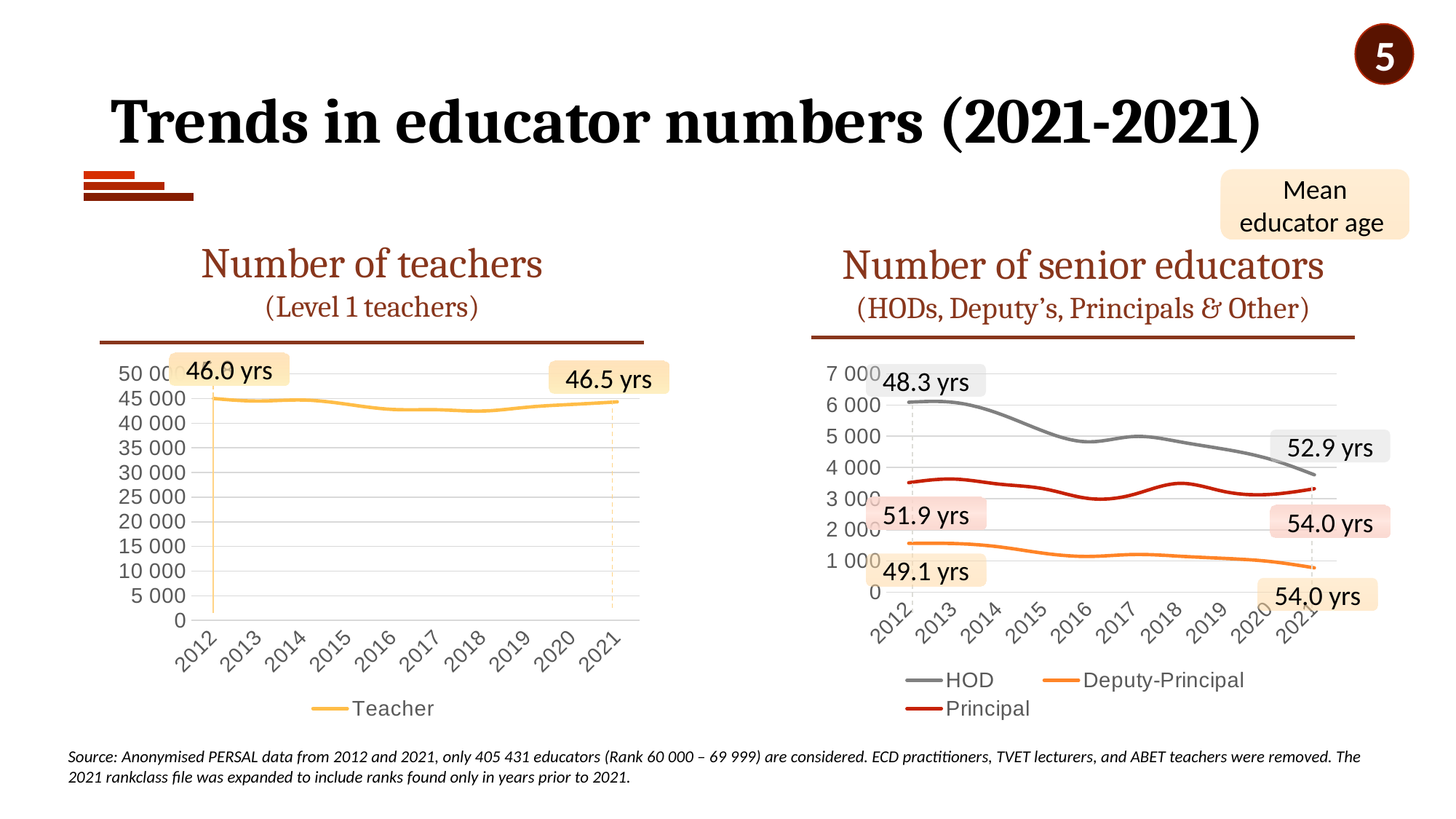
In the 'Number of senior educators' chart, is the Deputy-Principal value for 2021 greater or less than 1 000? less In the 'Number of senior educators' chart, is the Principal value for 2012 greater or less than 3 000? greater In the 'Number of teachers' chart, is the Teacher value for 2018 greater or less than 40 000? greater What mean educator age is shown for HODs in 2012 on the 'Number of senior educators' chart? 48.3 yrs What type of chart is the 'Number of teachers' chart? Line chart In the 'Number of senior educators' chart, does the HOD line rise or fall from 2012 to 2021? Fall How many series does the legend of the 'Number of senior educators' chart list? 3 What mean educator age is shown for teachers in 2021 on the 'Number of teachers' chart? 46.5 yrs In the 'Number of senior educators' chart, which series has the lowest value in 2021? Deputy-Principal How many years are shown on the x axis of the 'Number of teachers' chart? 10 In the 'Number of senior educators' chart, which series has the higher value in 2012, HOD or Principal? HOD